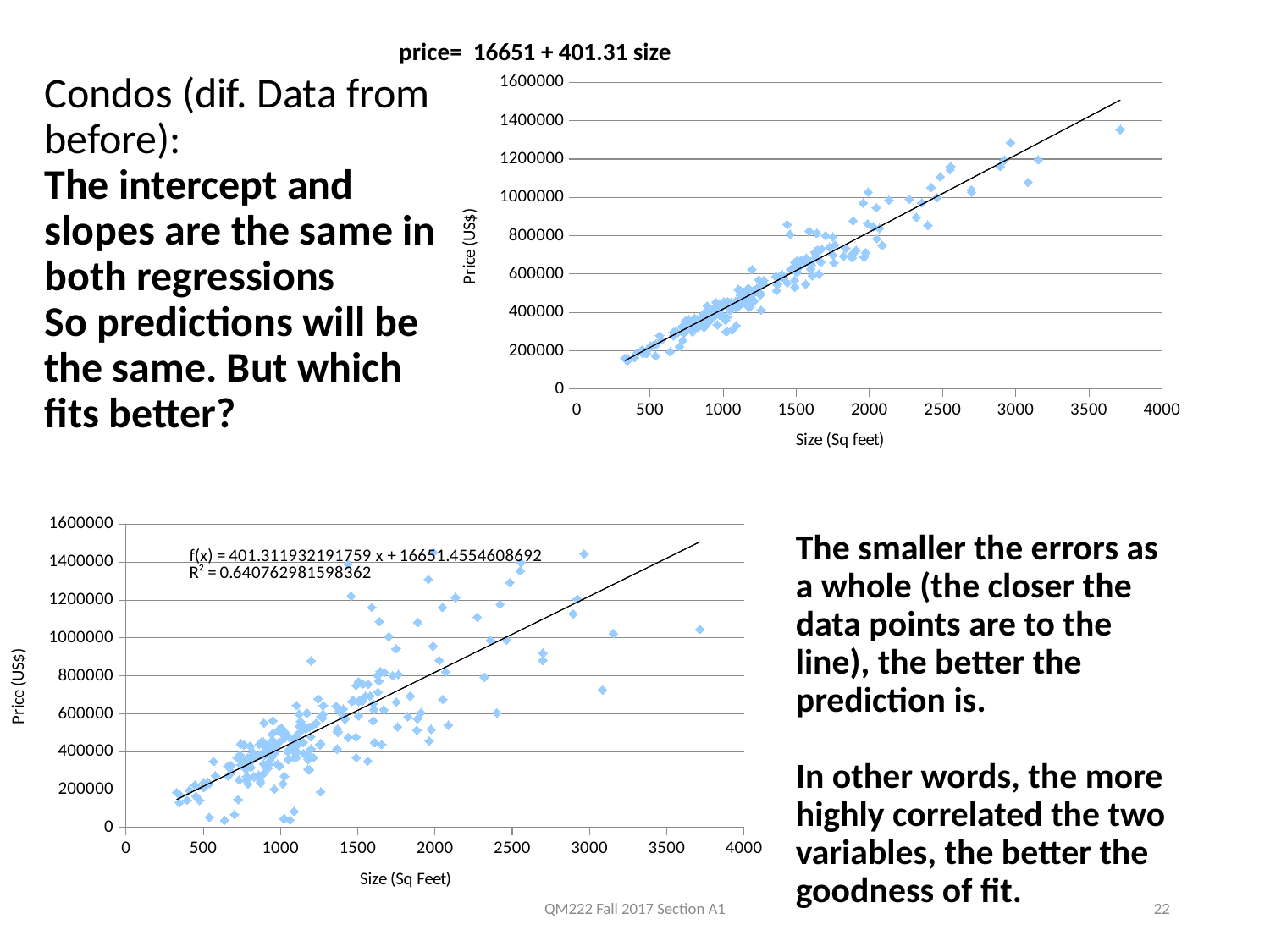
What kind of chart is the bottom chart on the slide? Scatter chart What is the highest value shown on the y axis of the bottom chart? 1600000 In the bottom chart, do the price values generally rise or fall as size increases along the x axis? Rise What is the title of the top chart? price= 16651 + 401.31 size What kind of chart is the top chart titled "price= 16651 + 401.31 size"? Scatter chart What is the highest value shown on the x axis of the top chart? 4000 What is the x-axis label of the top chart? Size (Sq feet) In the top chart, do the price values generally rise or fall as size increases along the x axis? Rise What is the R² value printed on the bottom chart? 0.640762981598362 What is the fitted equation printed on the bottom chart? f(x) = 401.311932191759 x + 16651.4554608692